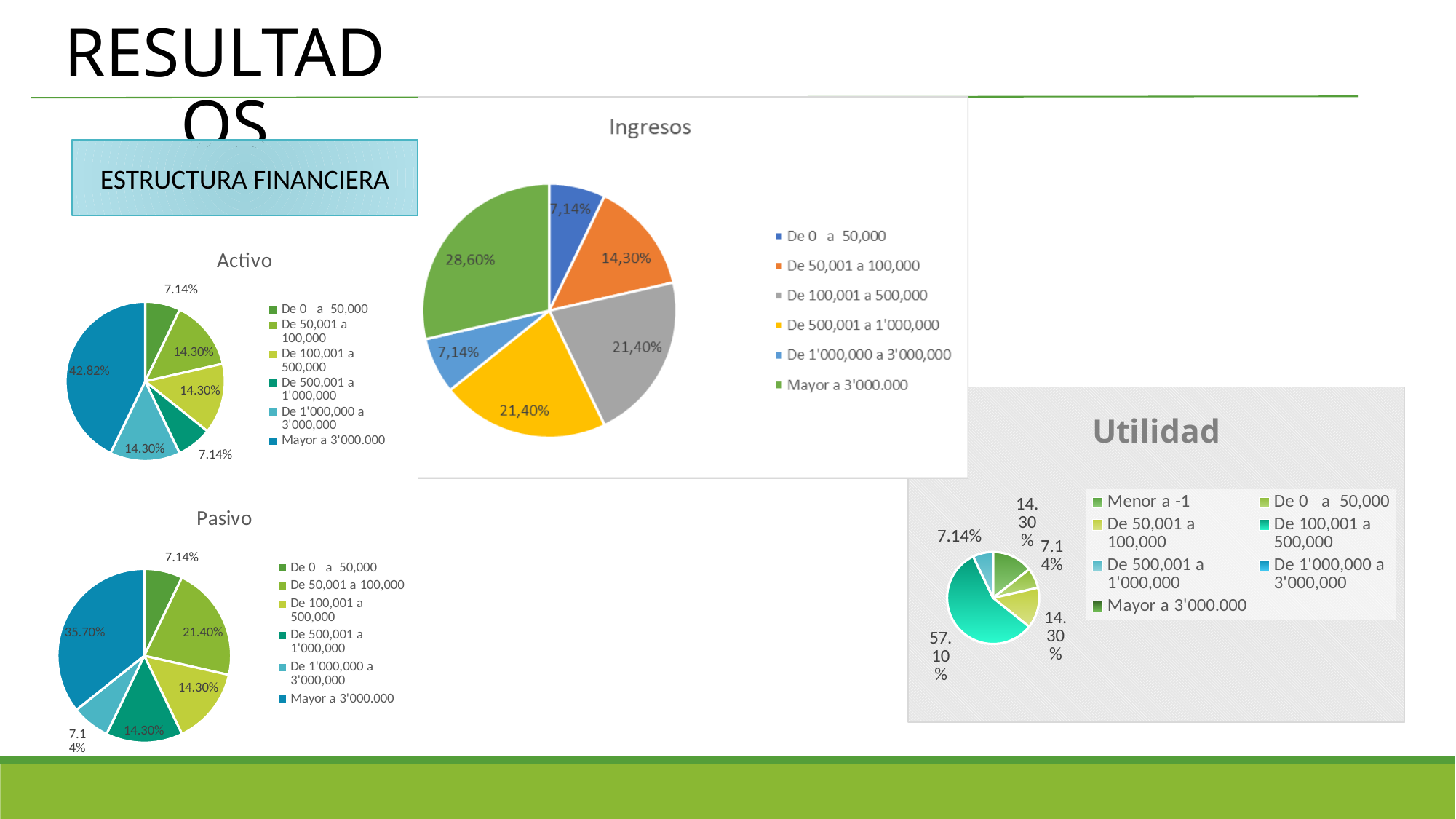
What type of chart is the Ingresos chart? Pie chart In the Ingresos pie chart, what is the share for Mayor a 3'000.000? 28,60% In the Activo pie chart, what is the share for Mayor a 3'000.000? 42.82% In the Activo pie chart, which category has the largest share? Mayor a 3'000.000 How many categories does the legend of the Ingresos pie chart list? 6 In the Pasivo pie chart, what is the share for De 50,001 a 100,000? 21.40% In the Pasivo pie chart, what is the difference between the shares for Mayor a 3'000.000 and De 50,001 a 100,000? 14.30% In the Utilidad pie chart, what is the largest share shown? 57.10% How many categories does the legend of the Utilidad chart list? 7 In the Ingresos pie chart, what is the share for De 50,001 a 100,000? 14,30% In the Ingresos pie chart, which is larger: the share for De 100,001 a 500,000 or the share for De 0 a 50,000? De 100,001 a 500,000 In the Pasivo pie chart, what is the share for Mayor a 3'000.000? 35.70%